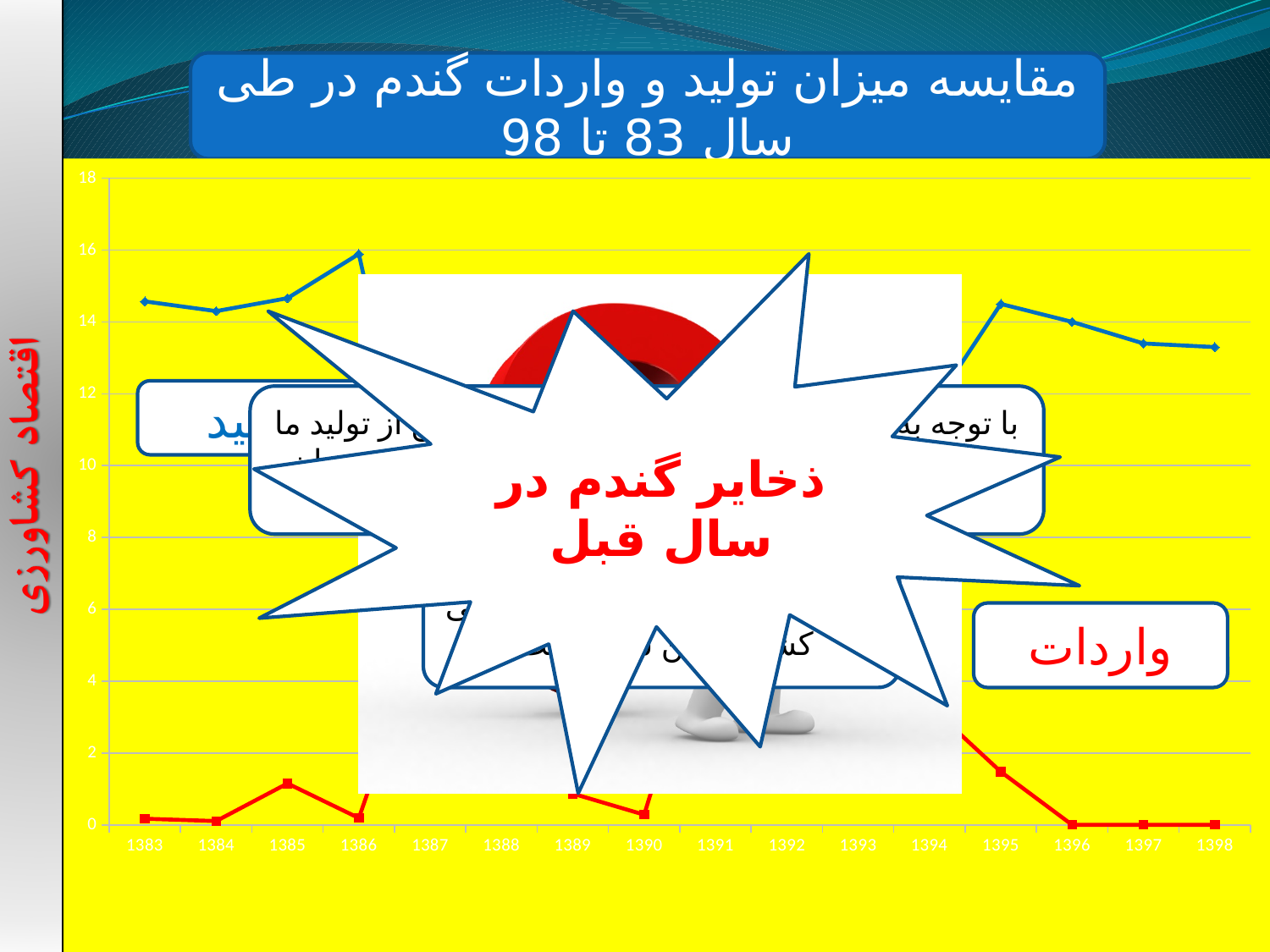
How many data series (lines) are plotted on the chart? 2 What kind of chart is shown on the slide? line chart What colour is the line for واردات (imports)? red Is the value of the blue line (تولید) for 1386 greater or less than 14? greater Which is larger in 1383: the value of the blue line (تولید) or the red line (واردات)? تولید (blue line) Is the value of the red line (واردات) for 1385 greater or less than 2? less What is the title of the slide's chart? مقایسه میزان تولید و واردات گندم در طی سال 83 تا 98 Is the value of the blue line (تولید) for 1398 greater or less than 12? greater Which is larger for the blue line (تولید): the value in 1386 or the value in 1398? 1386 How many years are labelled along the x axis of the chart? 16 Does the blue line (تولید) rise or fall from 1395 to 1398? fall